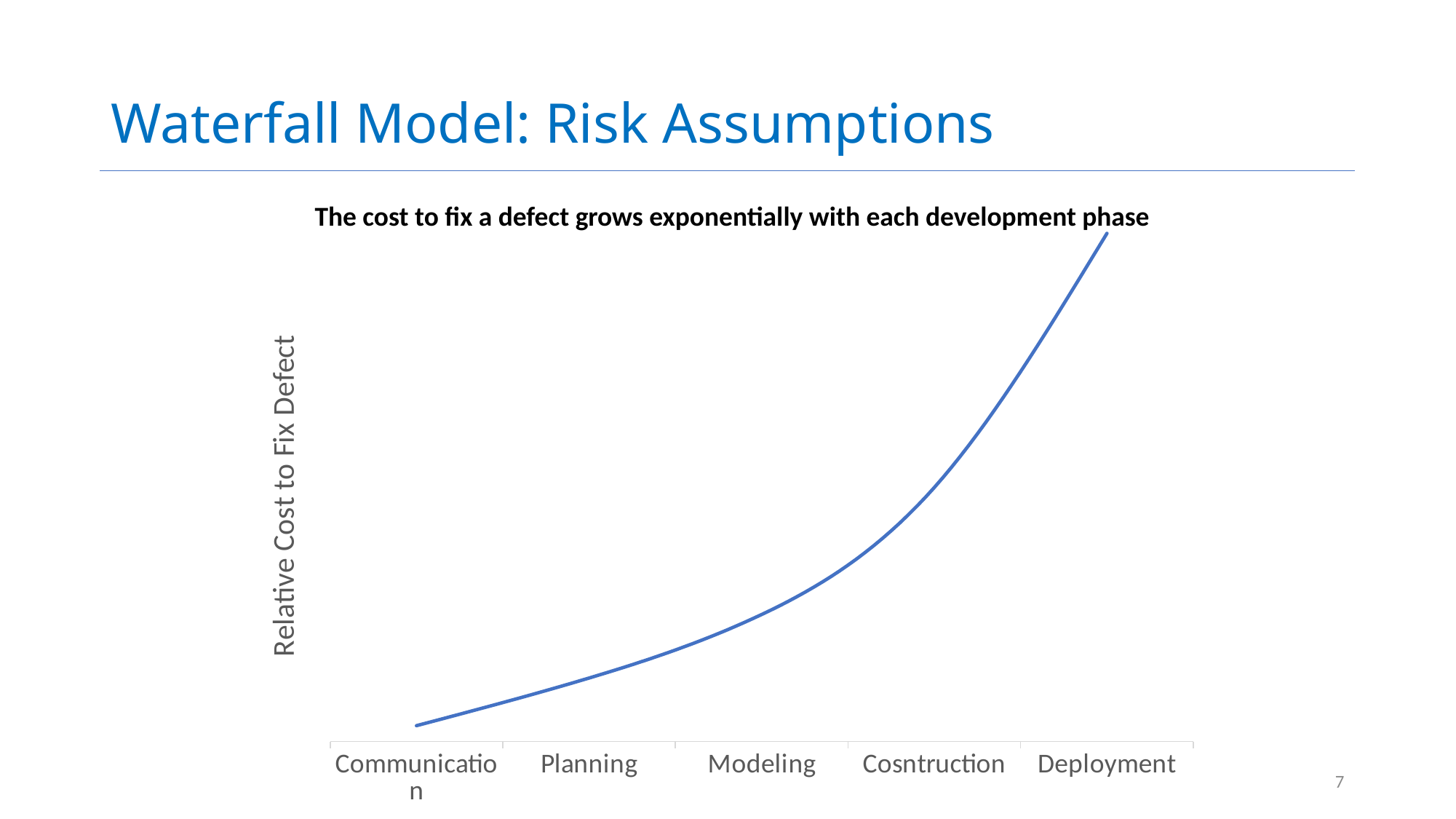
Does the relative cost to fix a defect rise or fall from Communication to Deployment? Rises What kind of chart is shown on the slide? Line chart How many development phases are shown on the x axis of the chart? 5 What is the title of the chart? The cost to fix a defect grows exponentially with each development phase Which phase has a lower relative cost to fix a defect, Planning or Construction? Planning Which development phase has the highest relative cost to fix a defect? Deployment Which phase appears immediately after Modeling on the x axis? Cosntruction Which development phase has the lowest relative cost to fix a defect? Communication What is the label on the vertical axis of the chart? Relative Cost to Fix Defect Which phase has a higher relative cost to fix a defect, Modeling or Deployment? Deployment